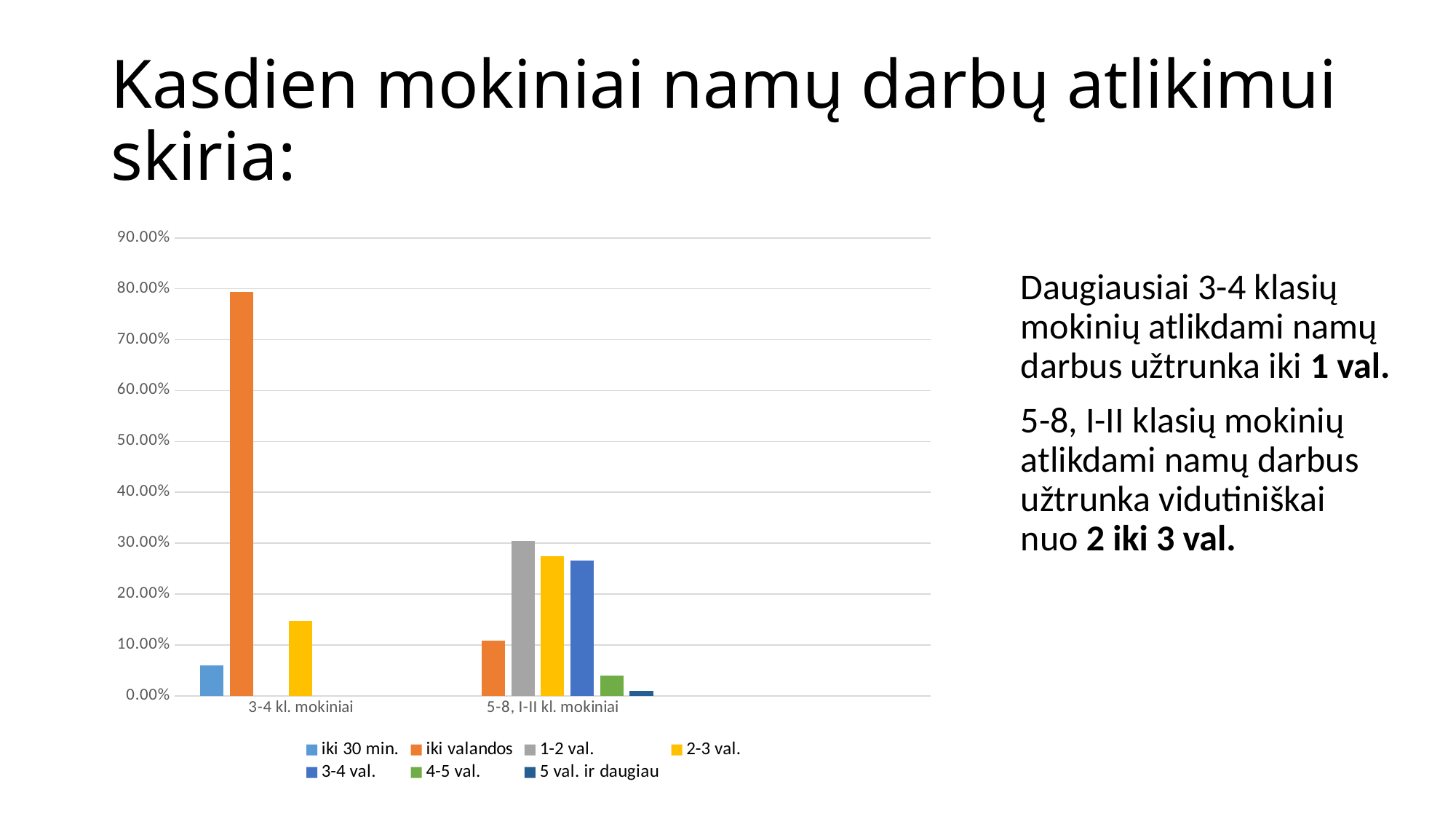
Is the value of "2-3 val." for "3-4 kl. mokiniai" greater or less than 20.00%? less What kind of chart is shown on the slide? bar chart Which series has the highest value for the category "3-4 kl. mokiniai"? iki valandos Which category has the larger value for "2-3 val.": "3-4 kl. mokiniai" or "5-8, I-II kl. mokiniai"? 5-8, I-II kl. mokiniai Is the value of "iki valandos" for "3-4 kl. mokiniai" greater or less than 70.00%? greater Which category has the larger value for "iki valandos": "3-4 kl. mokiniai" or "5-8, I-II kl. mokiniai"? 3-4 kl. mokiniai How many series does the chart's legend list? 7 Which series has the highest value for the category "5-8, I-II kl. mokiniai"? 1-2 val. What colour represents the "iki valandos" series in the chart's legend? orange Is the value of "iki 30 min." for "3-4 kl. mokiniai" greater or less than 10.00%? less How many categories are shown on the x axis of the chart? 2